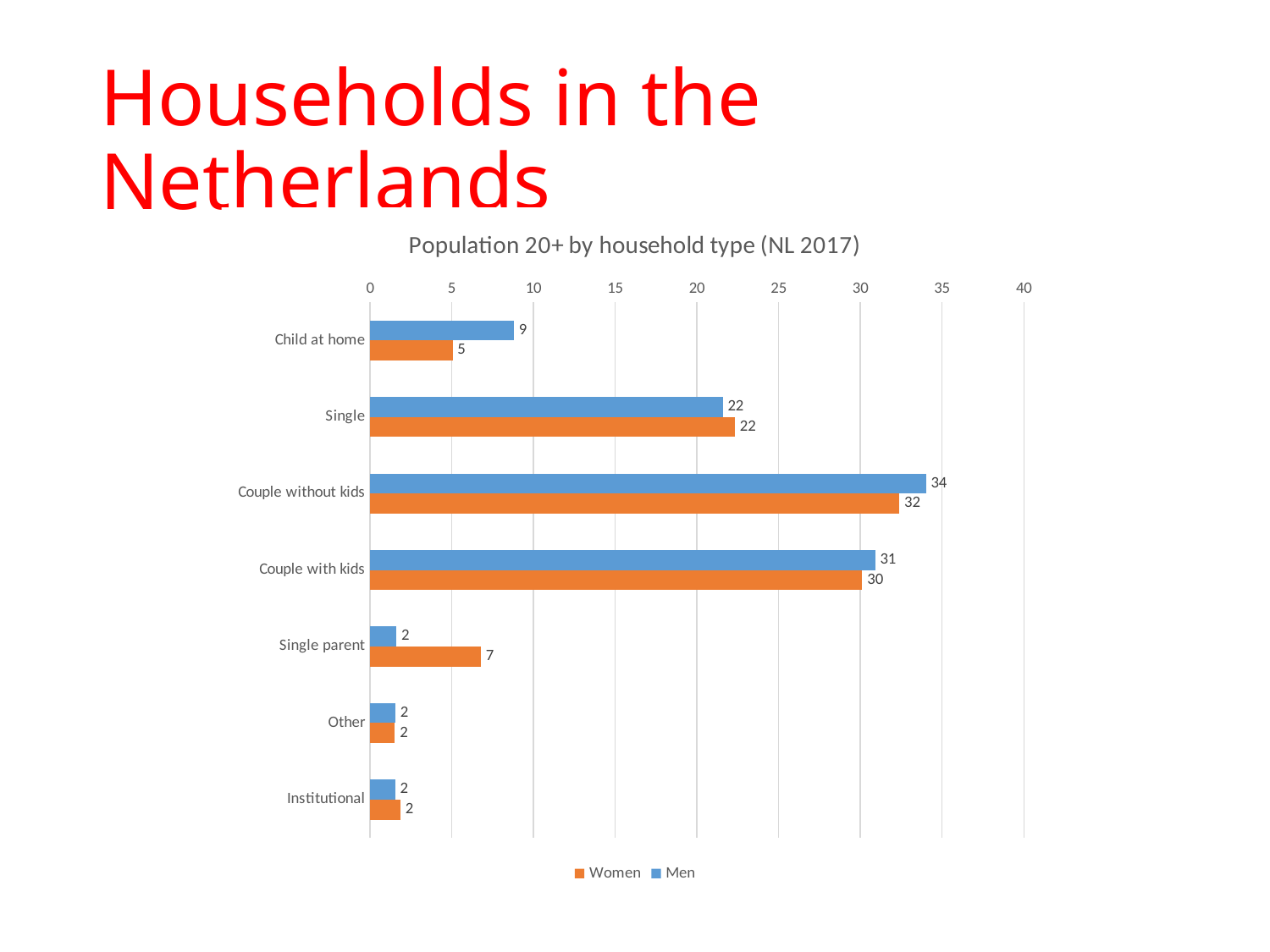
Which household type has the lowest value for Women? Other and Institutional (both 2) How many series does the legend list? 2 What is the difference between the Women values for Couple without kids and Couple with kids? 2 What is the value for Women in the Single parent category? 7 What is the value for Women in the Couple without kids category? 32 What is the difference between the Men and Women values for Child at home? 4 How many household type categories are shown on the chart? 7 What kind of chart is shown on the slide? Bar chart Which household type has the highest value for Men? Couple without kids Is the value for Men in the Couple with kids category greater or less than 30? greater Which is larger for Single parent, the value for Men or the value for Women? Women What is the value for Men in the Child at home category? 9